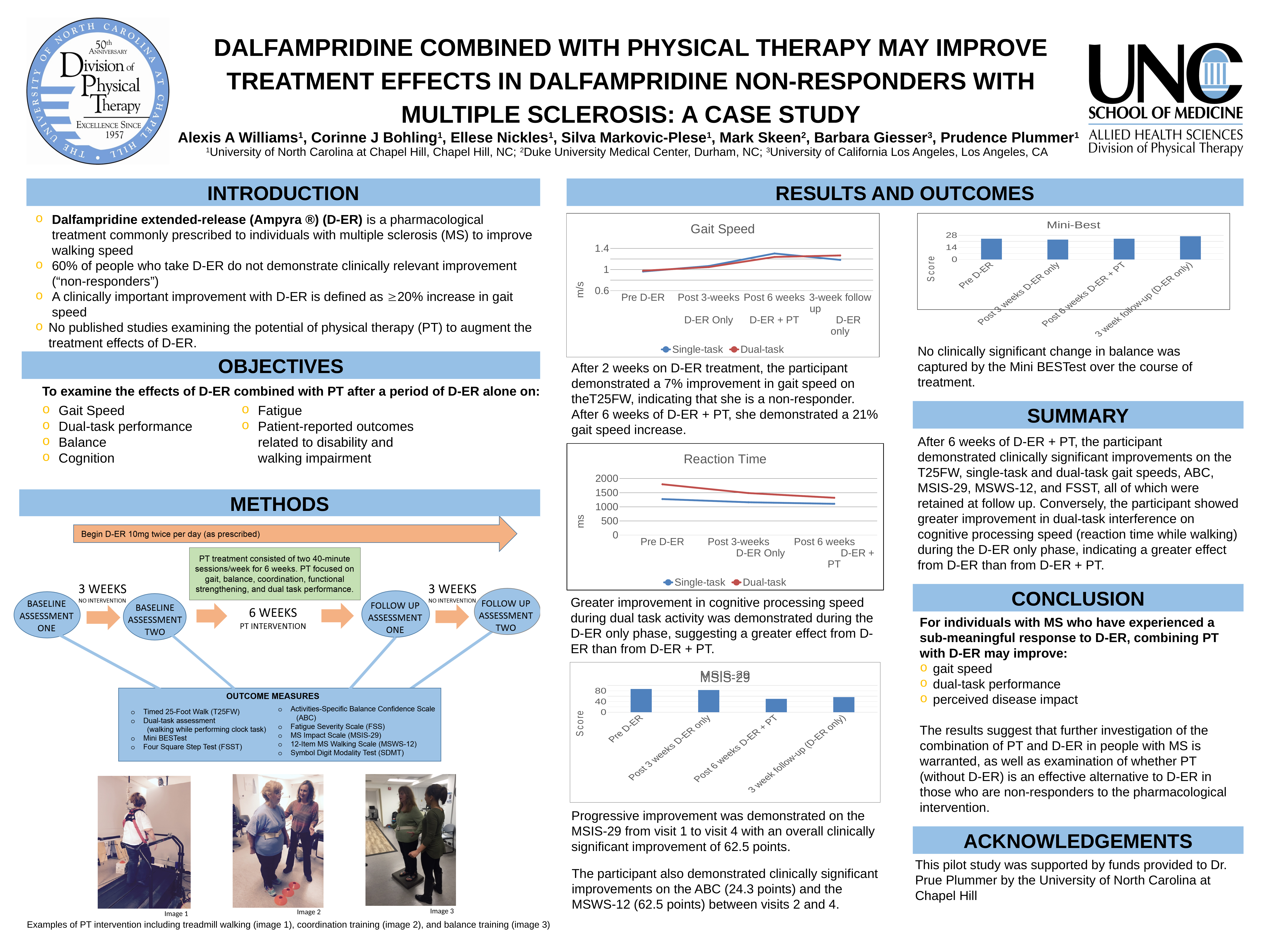
In the Reaction Time chart, which series has the higher value at Pre D-ER, Single-task or Dual-task? Dual-task In the MSIS-29 chart, which is larger, the value for Pre D-ER or the value for Post 6 weeks D-ER + PT? Pre D-ER In the Mini-Best chart, is the value for Pre D-ER greater or less than 14? greater In the Reaction Time chart, does the Dual-task line rise or fall from Pre D-ER to Post 6 weeks? fall How many time points are plotted along the x axis of the Gait Speed chart? 4 How many series does the legend of the Gait Speed chart list? 2 What kind of chart is the Mini-Best chart? bar chart In the Reaction Time chart, is the Single-task value at Pre D-ER greater or less than 1500? less What kind of chart is the Gait Speed chart? line chart In the Gait Speed chart, does the Single-task line rise or fall from Pre D-ER to Post 6 weeks? rise In the Reaction Time chart, is the Dual-task value at Pre D-ER greater or less than 1500? greater